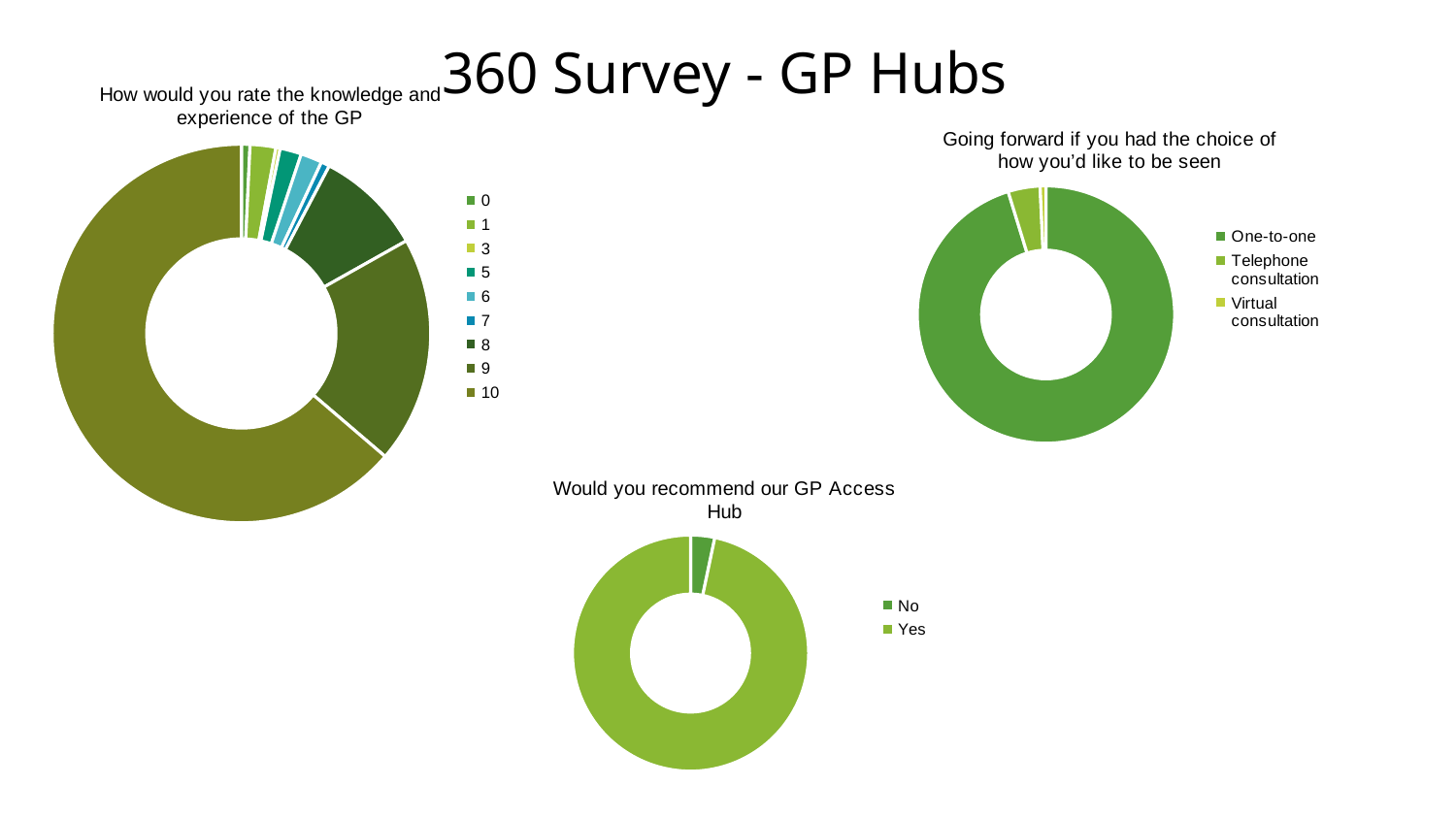
How many rating categories does the legend list for the chart "How would you rate the knowledge and experience of the GP"? 9 How many categories does the legend list for the chart "Going forward if you had the choice of how you'd like to be seen"? 3 What is the title of the slide containing the three doughnut charts? 360 Survey - GP Hubs In the chart "Going forward if you had the choice of how you'd like to be seen", which is larger, Telephone consultation or One-to-one? One-to-one How many entries does the legend list for the chart "Would you recommend our GP Access Hub"? 2 In the chart "How would you rate the knowledge and experience of the GP", which rating has the largest share? 10 In the chart "Going forward if you had the choice of how you'd like to be seen", which option has the largest share? One-to-one In the chart "How would you rate the knowledge and experience of the GP", which is larger, the share for 9 or the share for 8? 9 In the chart "Would you recommend our GP Access Hub", which response has the largest share? Yes In the chart "Going forward if you had the choice of how you'd like to be seen", which option has the smallest share? Virtual consultation In the chart "Would you recommend our GP Access Hub", which is larger, No or Yes? Yes What type of chart is used for "Would you recommend our GP Access Hub"? doughnut chart